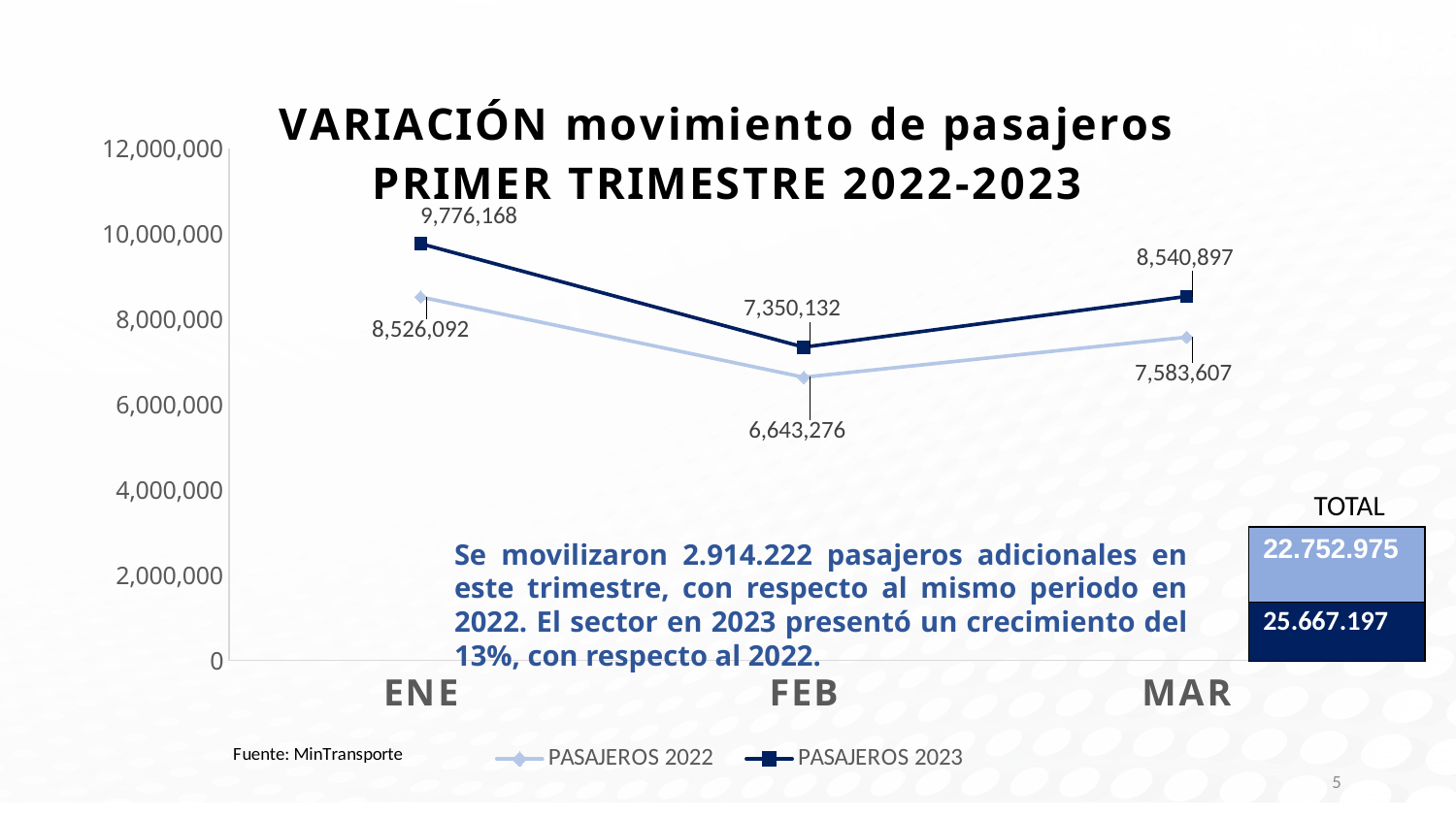
In which month is PASAJEROS 2022 highest? ENE What is the difference between PASAJEROS 2023 and PASAJEROS 2022 in ENE? 1,250,076 How many series does the legend list? 2 What kind of chart is shown on the slide? line chart Which is larger in MAR, PASAJEROS 2022 or PASAJEROS 2023? PASAJEROS 2023 What is the value for PASAJEROS 2022 in MAR? 7,583,607 Between ENE and FEB, does the PASAJEROS 2023 line rise or fall? fall What is the value for PASAJEROS 2023 in ENE? 9,776,168 In which month is PASAJEROS 2023 lowest? FEB What is the value for PASAJEROS 2022 in FEB? 6,643,276 What is the difference between PASAJEROS 2023 and PASAJEROS 2022 in FEB? 706,856 What is the value for PASAJEROS 2023 in MAR? 8,540,897